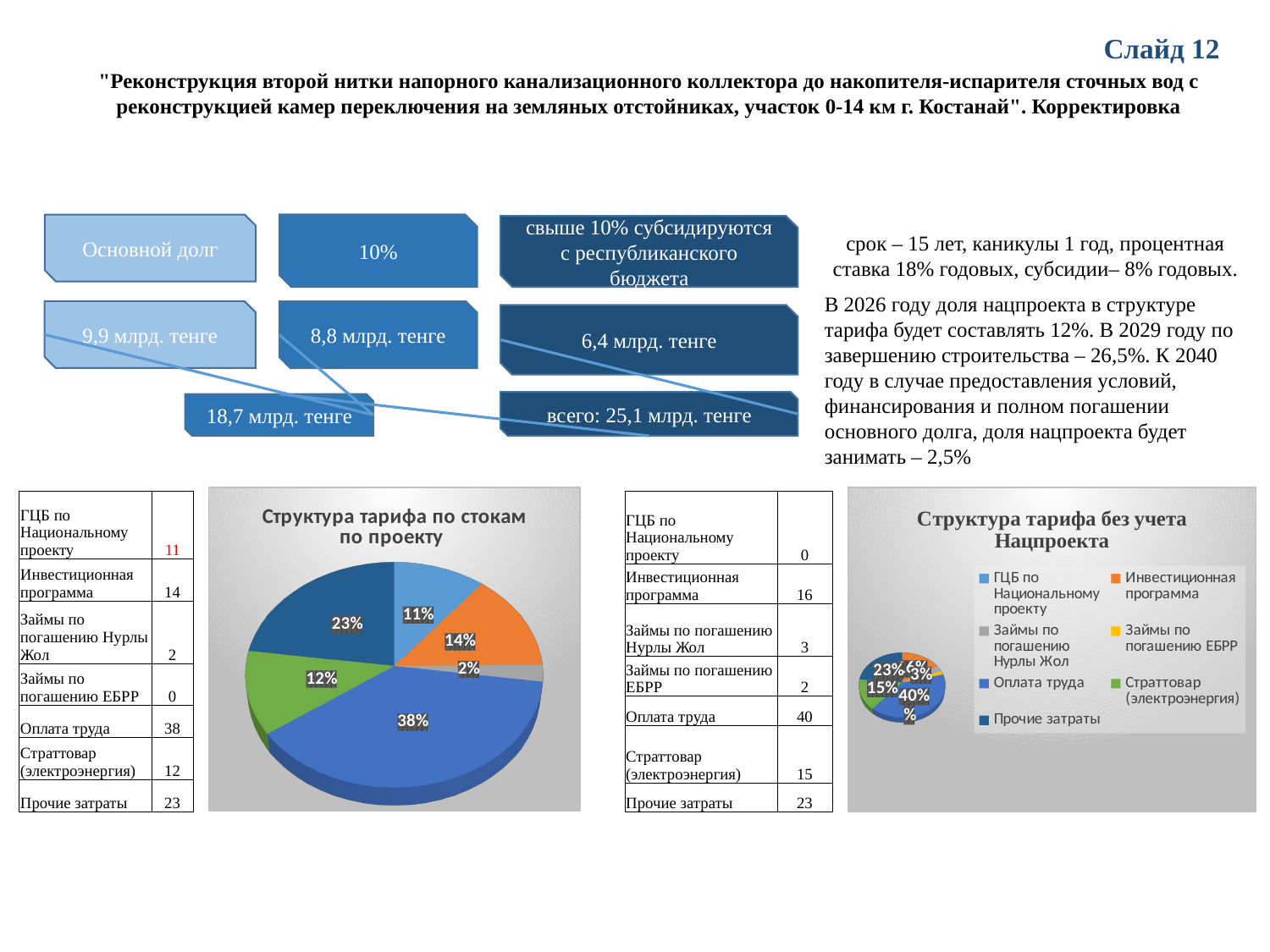
In the right chart "Структура тарифа без учета Нацпроекта", what is the largest slice's share? 40% In the left chart "Структура тарифа по стокам по проекту", what is the largest slice's share? 38% How many entries does the legend of the right chart "Структура тарифа без учета Нацпроекта" list? 7 In the right chart "Структура тарифа без учета Нацпроекта", which is larger: the 23% slice or the 15% slice? 23% In the left chart "Структура тарифа по стокам по проекту", what is the smallest labeled slice's share? 2% What kind of chart is the right chart "Структура тарифа без учета Нацпроекта"? pie chart According to the table beside the left chart, which category corresponds to the 38% slice in "Структура тарифа по стокам по проекту"? Оплата труда In the left chart "Структура тарифа по стокам по проекту", what is the difference between the largest slice (38%) and the 23% slice? 15 percentage points What kind of chart is the left chart titled "Структура тарифа по стокам по проекту"? pie chart How many slices carry a percentage label in the left chart "Структура тарифа по стокам по проекту"? 6 In the left chart "Структура тарифа по стокам по проекту", which is larger: the 23% slice or the 14% slice? 23% What is the title of the right chart? Структура тарифа без учета Нацпроекта